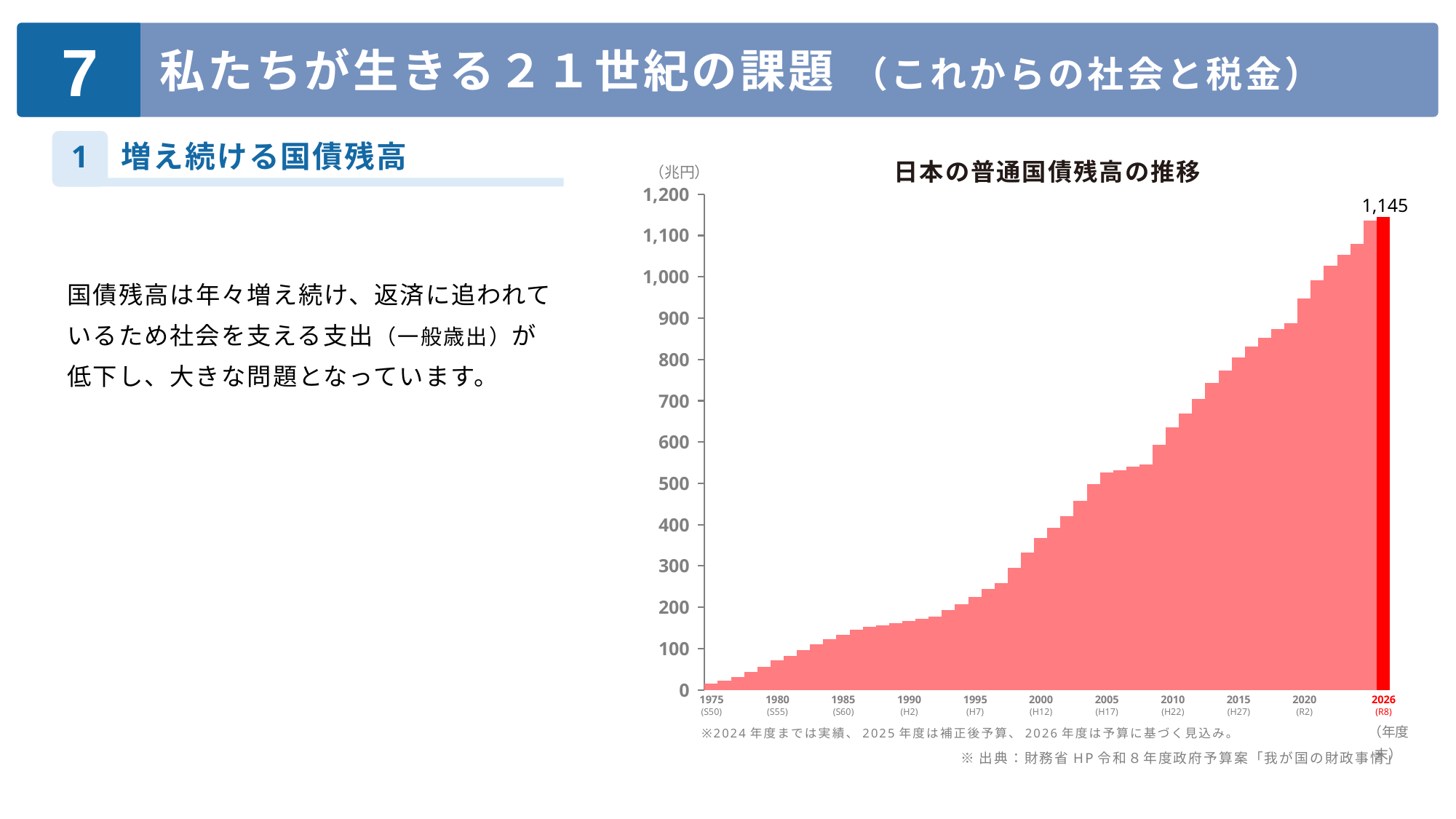
What unit is shown on the vertical axis of the chart? 兆円 Do the values rise or fall from 1975 to 2026? Rise What is the title of the chart? 日本の普通国債残高の推移 What kind of chart is shown on the slide? Bar chart Is the value for 2020 greater or less than 800? greater What is the value shown for 2026 in the chart? 1,145 Which year has the highest value in the chart? 2026 Which year has the lowest value in the chart? 1975 Is the value for 1990 greater or less than 200? less Is the value for 1980 greater or less than 100? less